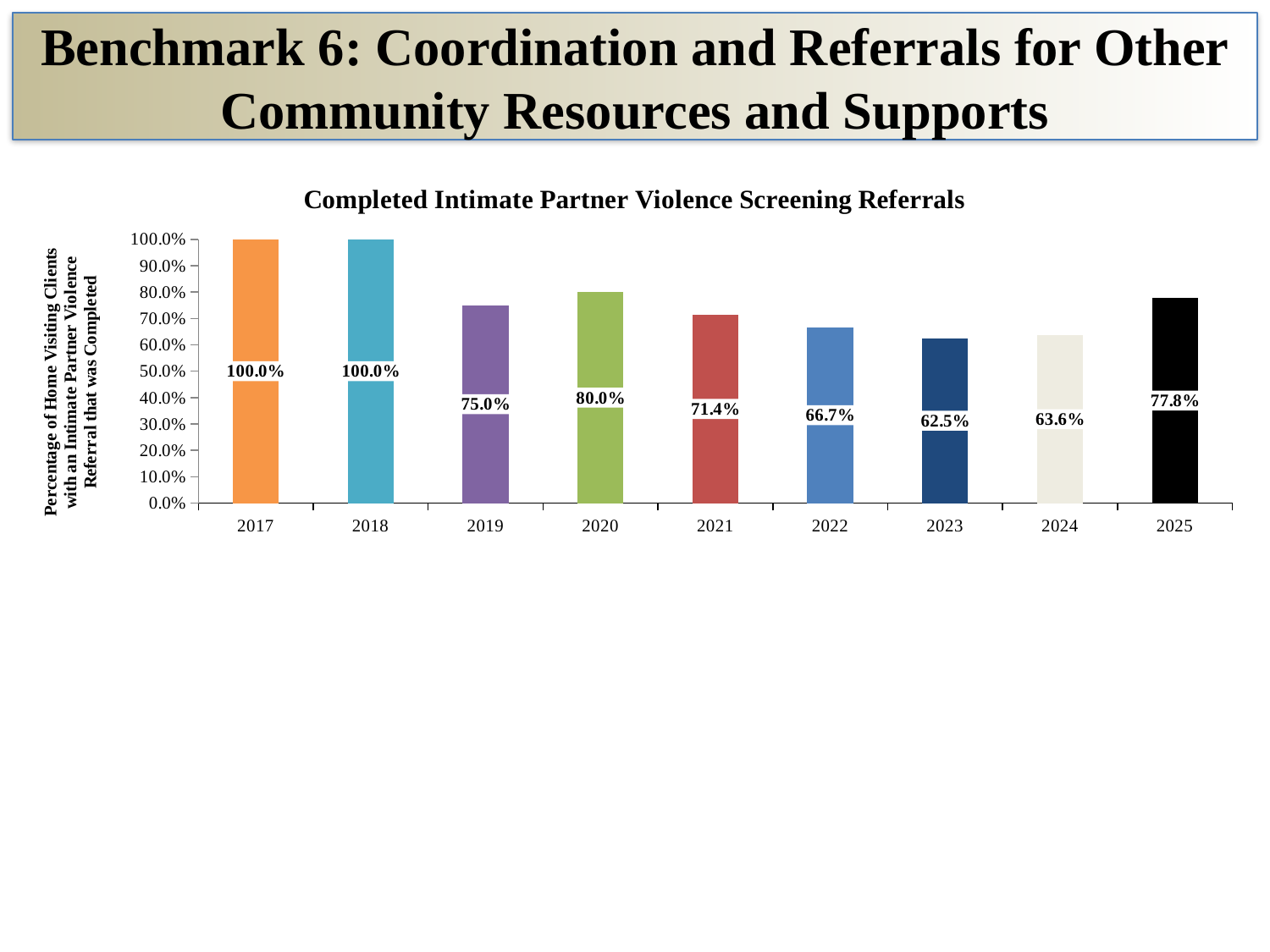
Which year has the lowest value? 2023 Which is larger, the value for 2022 or the value for 2024? 2022 What is the value for 2025? 77.8% What kind of chart is this? bar chart What is the value for 2019? 75.0% What is the title of the chart? Completed Intimate Partner Violence Screening Referrals What is the value for 2023? 62.5% How many years are shown on the x axis? 9 Do the values generally rise or fall from 2018 to 2023? fall What is the difference between the values for 2017 and 2025? 22.2% What is the difference between the values for 2020 and 2021? 8.6% Is the value for 2021 greater or less than 60.0%? greater